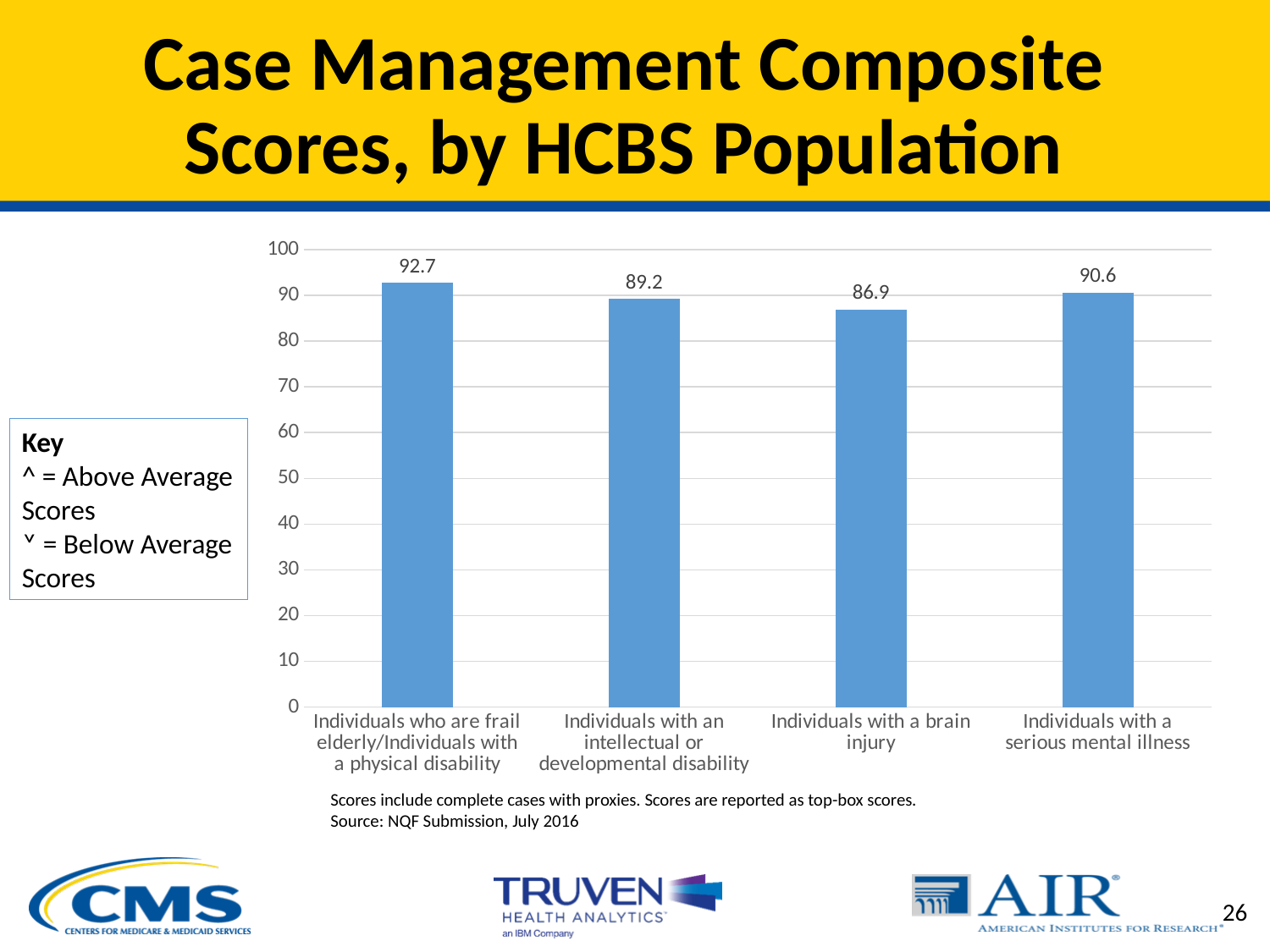
Which HCBS population has the lowest case management composite score? Individuals with a brain injury What is the title of the slide containing the chart? Case Management Composite Scores, by HCBS Population What kind of chart is shown on the slide? Bar chart What is the difference between the score for individuals who are frail elderly/individuals with a physical disability and the score for individuals with a brain injury? 5.8 What is the difference between the score for individuals with a serious mental illness and the score for individuals with an intellectual or developmental disability? 1.4 Is the score for individuals with a brain injury greater or less than 90? less What is the case management composite score for individuals with a serious mental illness? 90.6 How many HCBS populations are shown in the chart? 4 Which is larger: the score for individuals with a serious mental illness or the score for individuals with an intellectual or developmental disability? Individuals with a serious mental illness What is the case management composite score for individuals with a brain injury? 86.9 What is the score for individuals with an intellectual or developmental disability? 89.2 Which HCBS population has the highest case management composite score? Individuals who are frail elderly/Individuals with a physical disability